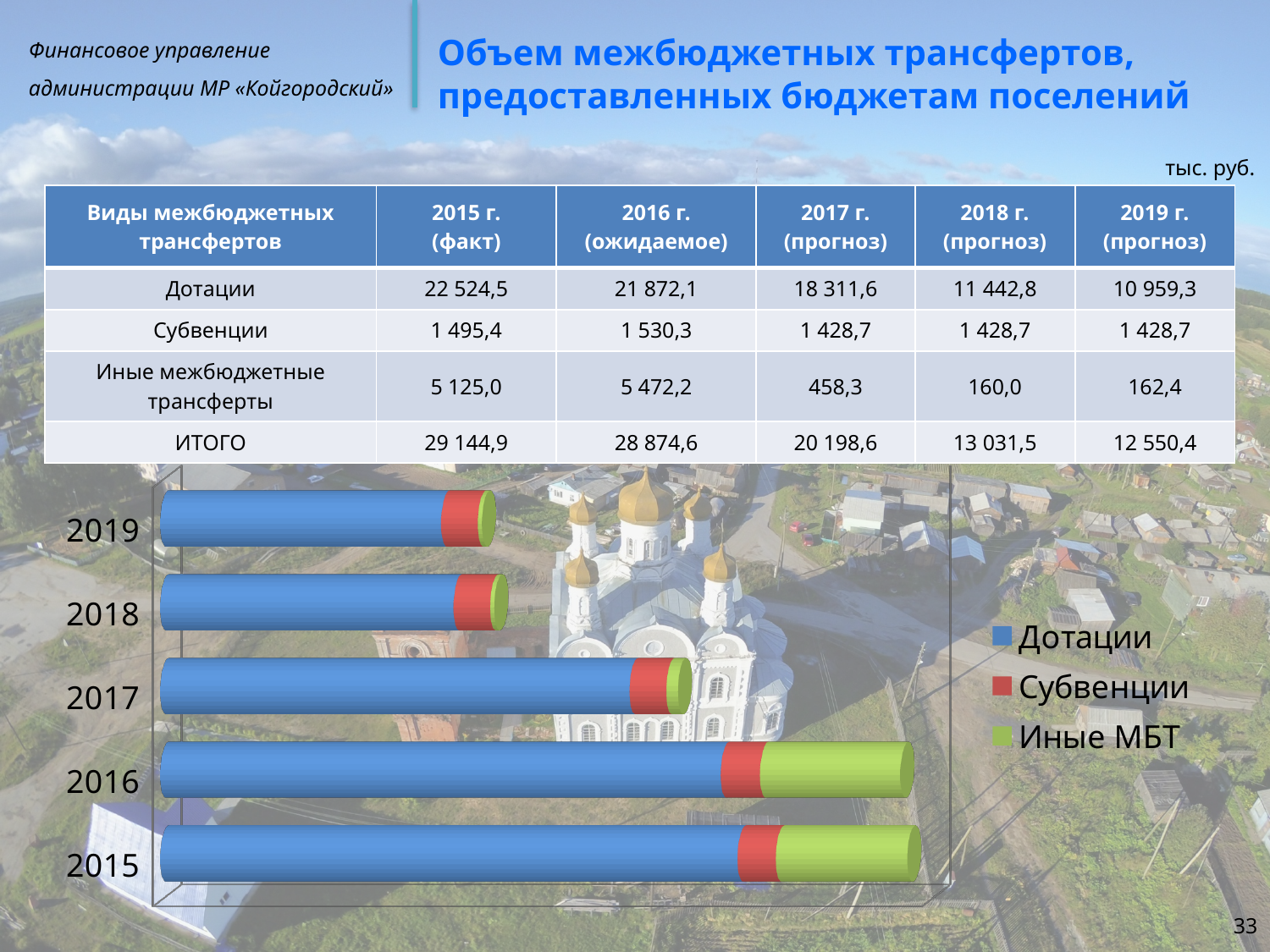
Which year has the longest total bar in the chart? 2015 Do the total bar lengths rise or fall from 2015 to 2019? Fall Which year has the shortest total bar in the chart? 2019 What kind of chart is shown on the slide? Stacked bar chart What is the value of Дотации for 2015 (факт)? 22 524,5 Which series is shown in green in the chart legend? Иные МБТ How many years (bars) are plotted in the chart? 5 Which is larger: Субвенции in 2016 or Субвенции in 2015? 2016 How many series does the chart legend list? 3 What is the total (ИТОГО) of intergovernmental transfers for 2016 (ожидаемое)? 28 874,6 What is the difference between Дотации in 2015 and Дотации in 2019? 11 565,2 What is the value of Иные межбюджетные трансферты for 2017 (прогноз)? 458,3